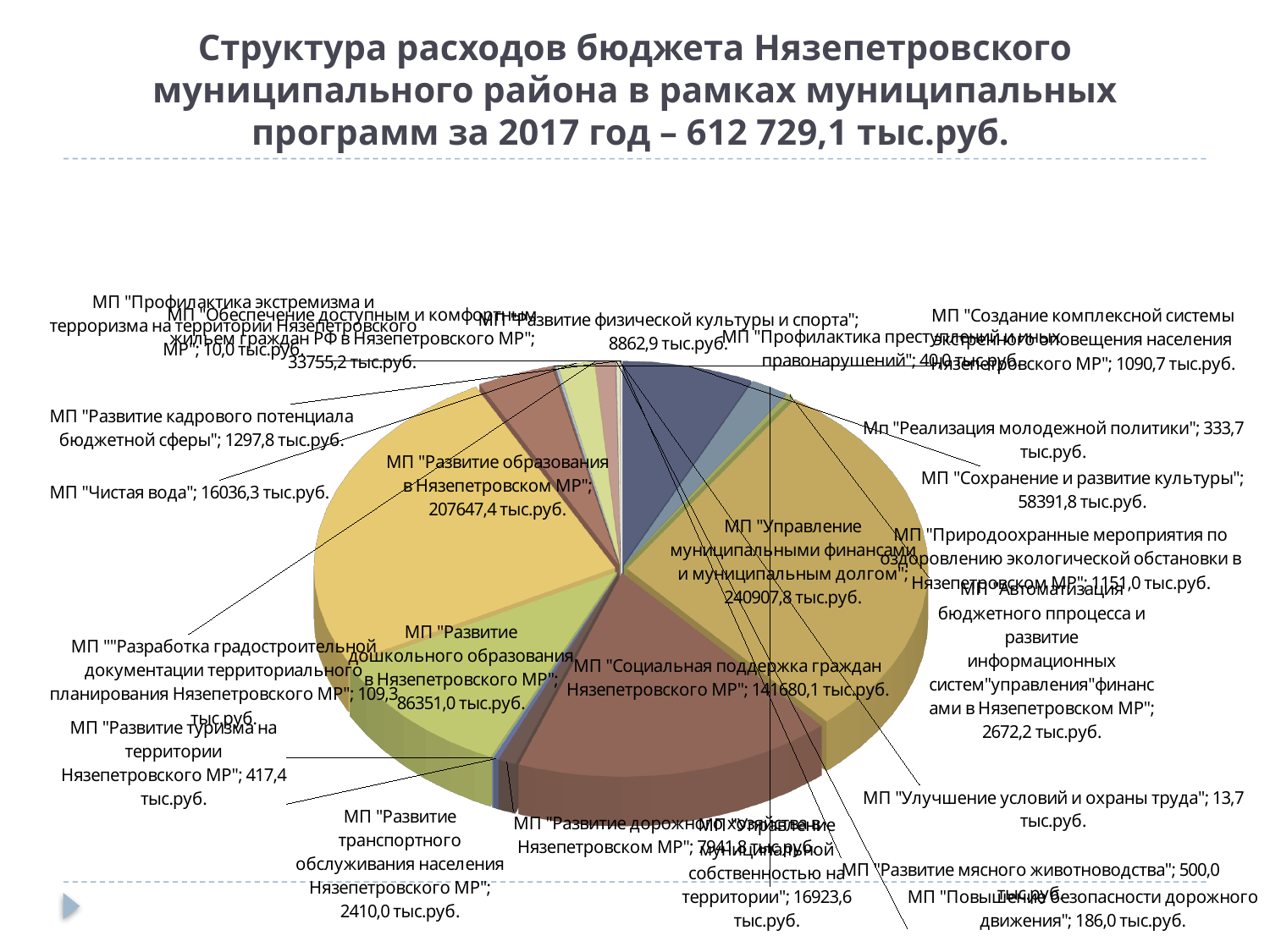
Which is larger: the value for МП "Улучшение условий и охраны труда" or МП "Повышение безопасности дорожного движения"? МП "Повышение безопасности дорожного движения" Which program has the smallest value in the chart? МП "Профилактика экстремизма и терроризма на территории Нязепетровского МР" What total amount of budget expenditures for 2017 is stated in the chart title? 612 729,1 тыс.руб. What type of chart is shown on the slide? Pie chart What is the difference between the values for МП "Управление муниципальными финансами и муниципальным долгом" and МП "Развитие образования в Нязепетровском МР"? 33260,4 тыс.руб. What is the value for МП "Развитие транспортного обслуживания населения Нязепетровского МР"? 2410,0 тыс.руб. What is the value for МП "Развитие образования в Нязепетровском МР"? 207647,4 тыс.руб. What is the value for МП "Чистая вода"? 16036,3 тыс.руб. Which is larger: the value for МП "Развитие дошкольного образования в Нязепетровском МР" or МП "Сохранение и развитие культуры"? МП "Развитие дошкольного образования в Нязепетровском МР" What is the value for МП "Сохранение и развитие культуры"? 58391,8 тыс.руб. What is the value for МП "Социальная поддержка граждан Нязепетровского МР"? 141680,1 тыс.руб. Which program has the largest share of the budget expenditures? МП "Управление муниципальными финансами и муниципальным долгом"